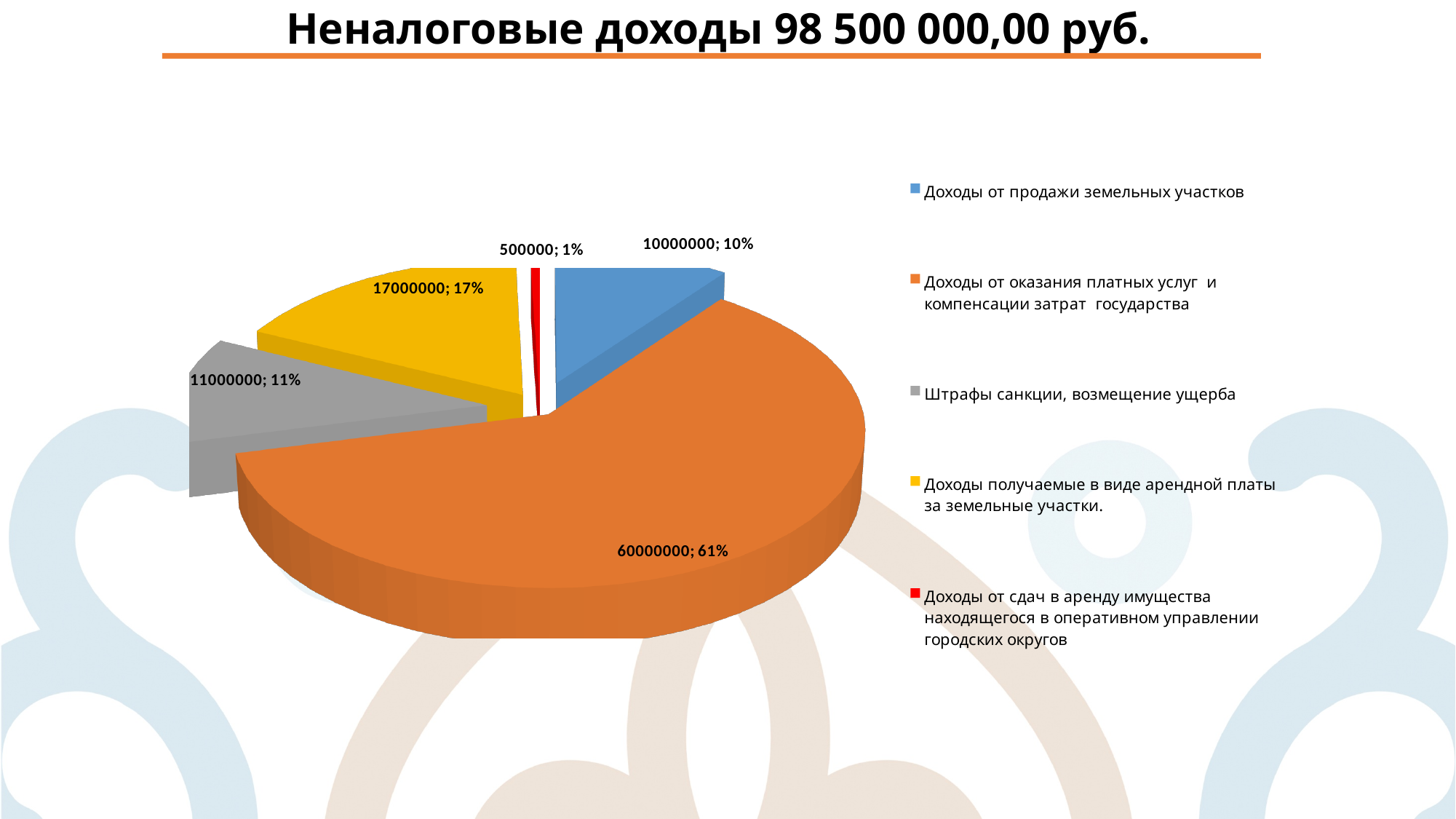
What value is shown for the slice 'Доходы от оказания платных услуг и компенсации затрат государства'? 60000000 What share of the pie does 'Доходы получаемые в виде арендной платы за земельные участки' represent? 17% What is the difference between the values for 'Доходы получаемые в виде арендной платы за земельные участки' and 'Штрафы санкции, возмещение ущерба'? 6000000 What kind of chart is shown on the slide? Pie chart What value is shown for the slice 'Доходы от продажи земельных участков'? 10000000 Which category has the largest slice of the pie? Доходы от оказания платных услуг и компенсации затрат государства What share of the pie does 'Доходы от сдач в аренду имущества находящегося в оперативном управлении городских округов' represent? 1% What value is shown for the slice 'Штрафы санкции, возмещение ущерба'? 11000000 What is the title of the chart on the slide? Неналоговые доходы 98 500 000,00 руб. Which is larger: the value for 'Доходы от продажи земельных участков' or for 'Штрафы санкции, возмещение ущерба'? Штрафы санкции, возмещение ущерба Which category has the smallest slice of the pie? Доходы от сдач в аренду имущества находящегося в оперативном управлении городских округов How many slices does the pie chart have? 5